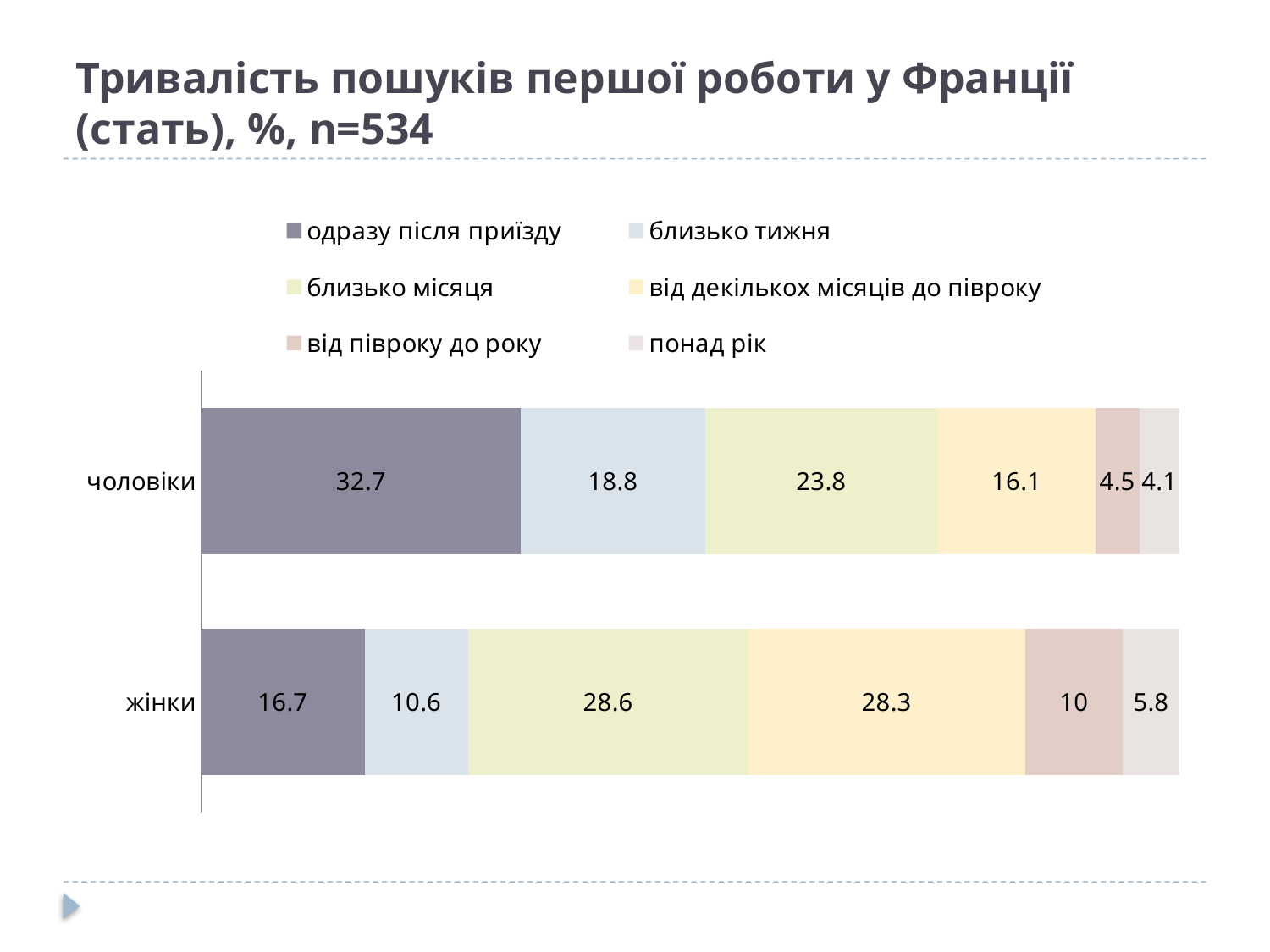
Which is larger: "від півроку до року" for "чоловіки" or for "жінки"? жінки What type of chart is shown on the slide? stacked bar chart What is the difference between the "одразу після приїзду" values for "чоловіки" and "жінки"? 16 What is the value of "близько тижня" for "жінки"? 10.6 What is the total of the "чоловіки" stacked bar? 100 Which segment is the smallest in the "чоловіки" bar? понад рік What is the value of "одразу після приїзду" for "чоловіки"? 32.7 How many series does the legend list? 6 What is the value of "від декількох місяців до півроку" for "жінки"? 28.3 Which segment is the largest in the "жінки" bar? близько місяця How many categories are plotted on the vertical axis? 2 What is the value of "понад рік" for "чоловіки"? 4.1